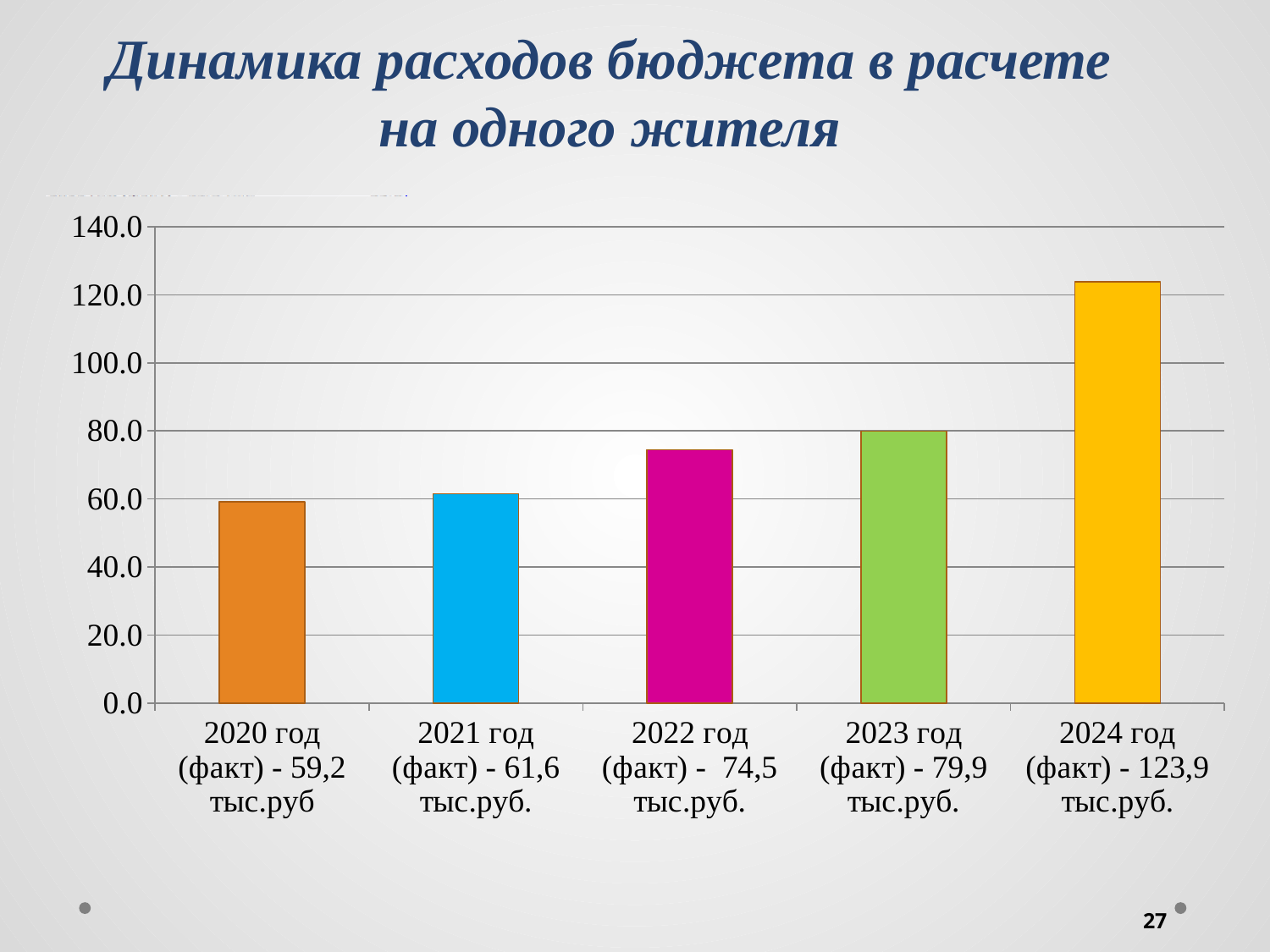
What is the difference between the 2021 and 2020 values? 2,4 тыс.руб. Which year has the lowest budget expenditure per resident? 2020 год How many years are shown on the chart? 5 What kind of chart is shown on the slide? bar chart What is the budget expenditure per resident for 2024 (факт)? 123,9 тыс.руб. Which is larger, the value for 2022 or the value for 2023? 2023 What is the budget expenditure per resident for 2020 (факт)? 59,2 тыс.руб Which year has the highest budget expenditure per resident? 2024 год Do the values rise or fall from 2020 to 2024? rise What is the budget expenditure per resident for 2022 (факт)? 74,5 тыс.руб. What is the difference between the 2024 and 2023 values? 44,0 тыс.руб. Is the value for 2024 greater or less than 120.0? greater